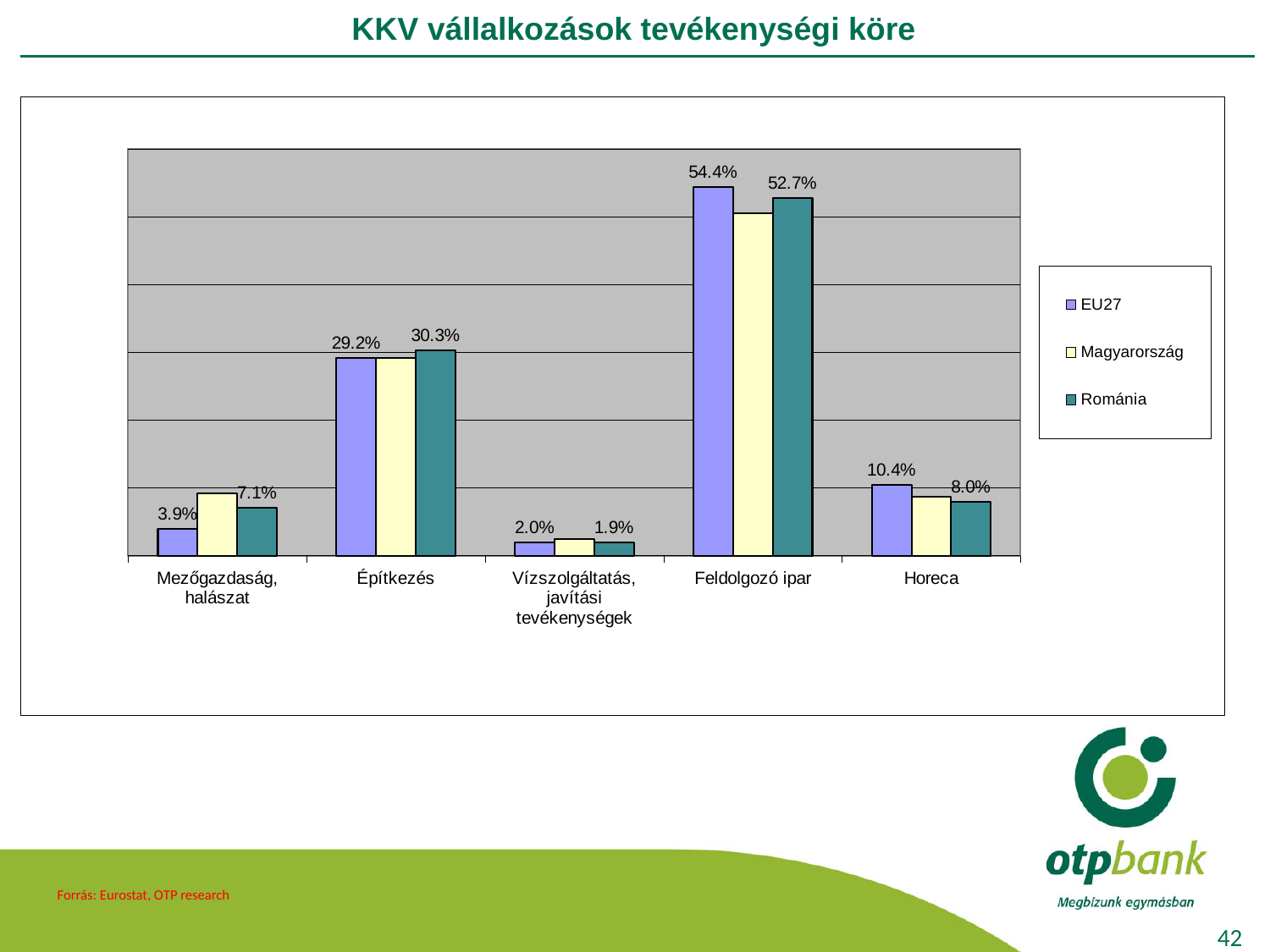
What is the Románia value for Építkezés? 30.3% Which category has the lowest Románia value? Vízszolgáltatás, javítási tevékenységek What kind of chart is shown on the slide? Bar chart What is the Románia value for Mezőgazdaság, halászat? 7.1% What is the EU27 value for Horeca? 10.4% For Mezőgazdaság, halászat, which is larger: the EU27 value or the Románia value? Románia What is the difference between the EU27 and Románia values for Feldolgozó ipar? 1.7% What is the EU27 value for Feldolgozó ipar? 54.4% How many series does the legend list? 3 How many categories are shown on the x axis? 5 What is the difference between the EU27 and Románia values for Horeca? 2.4% Which category has the highest EU27 value? Feldolgozó ipar